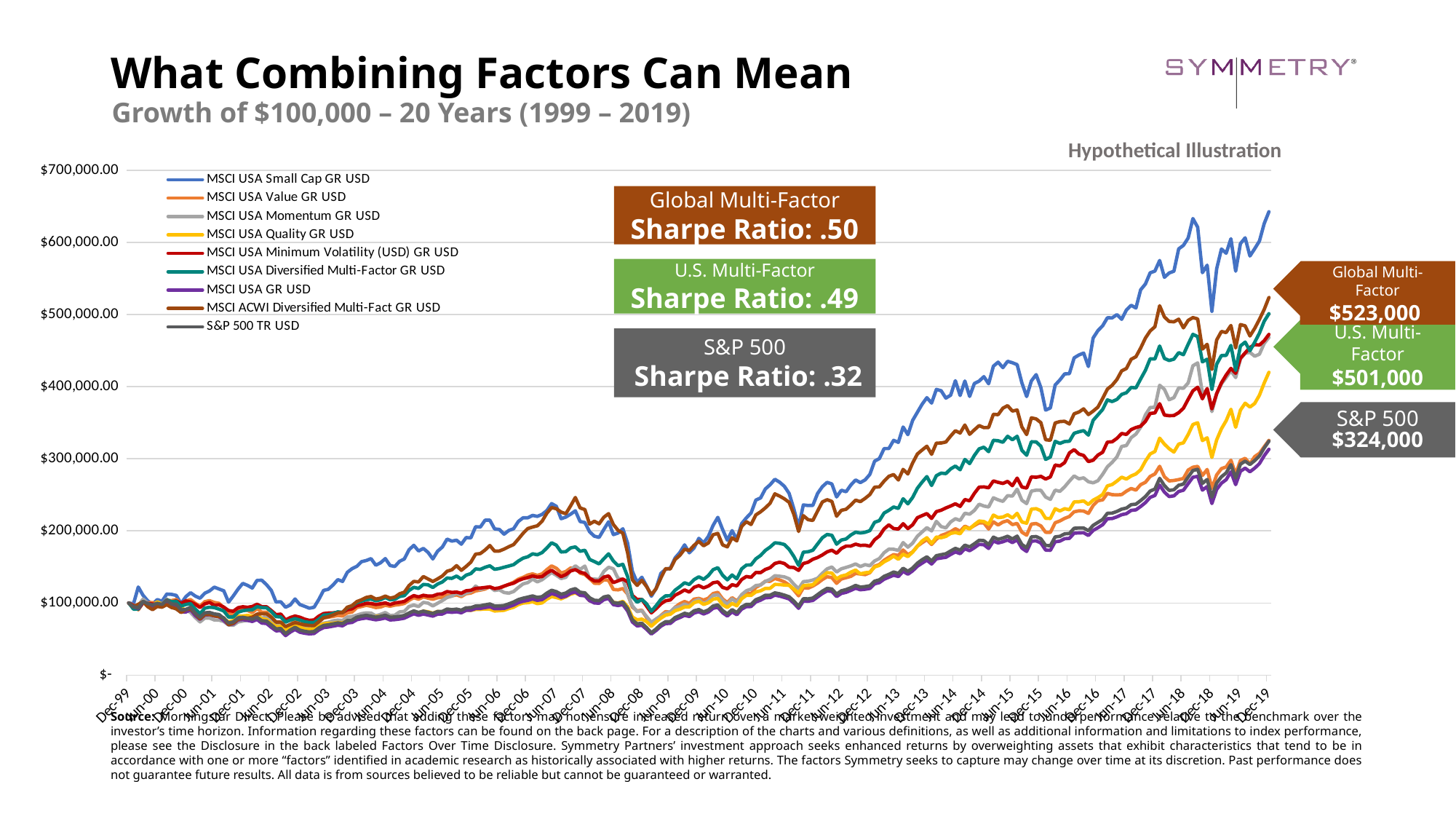
What ending value does the callout give for U.S. Multi-Factor? $501,000 Is the Dec-19 value for MSCI USA Quality GR USD greater or less than $500,000? less How many series does the chart's legend list? 9 What is the difference between the Global Multi-Factor ending value and the S&P 500 ending value? $199,000 What kind of chart is shown on the slide? line chart What ending value does the callout give for Global Multi-Factor? $523,000 Is the Dec-19 value for MSCI USA Small Cap GR USD greater or less than $600,000? greater What is the difference between the Global Multi-Factor and U.S. Multi-Factor ending values? $22,000 What ending value does the callout give for the S&P 500? $324,000 Which has the larger ending value, Global Multi-Factor or the S&P 500? Global Multi-Factor What Sharpe Ratio is shown for the S&P 500? .32 Which series ends at the highest value in Dec-19? MSCI USA Small Cap GR USD